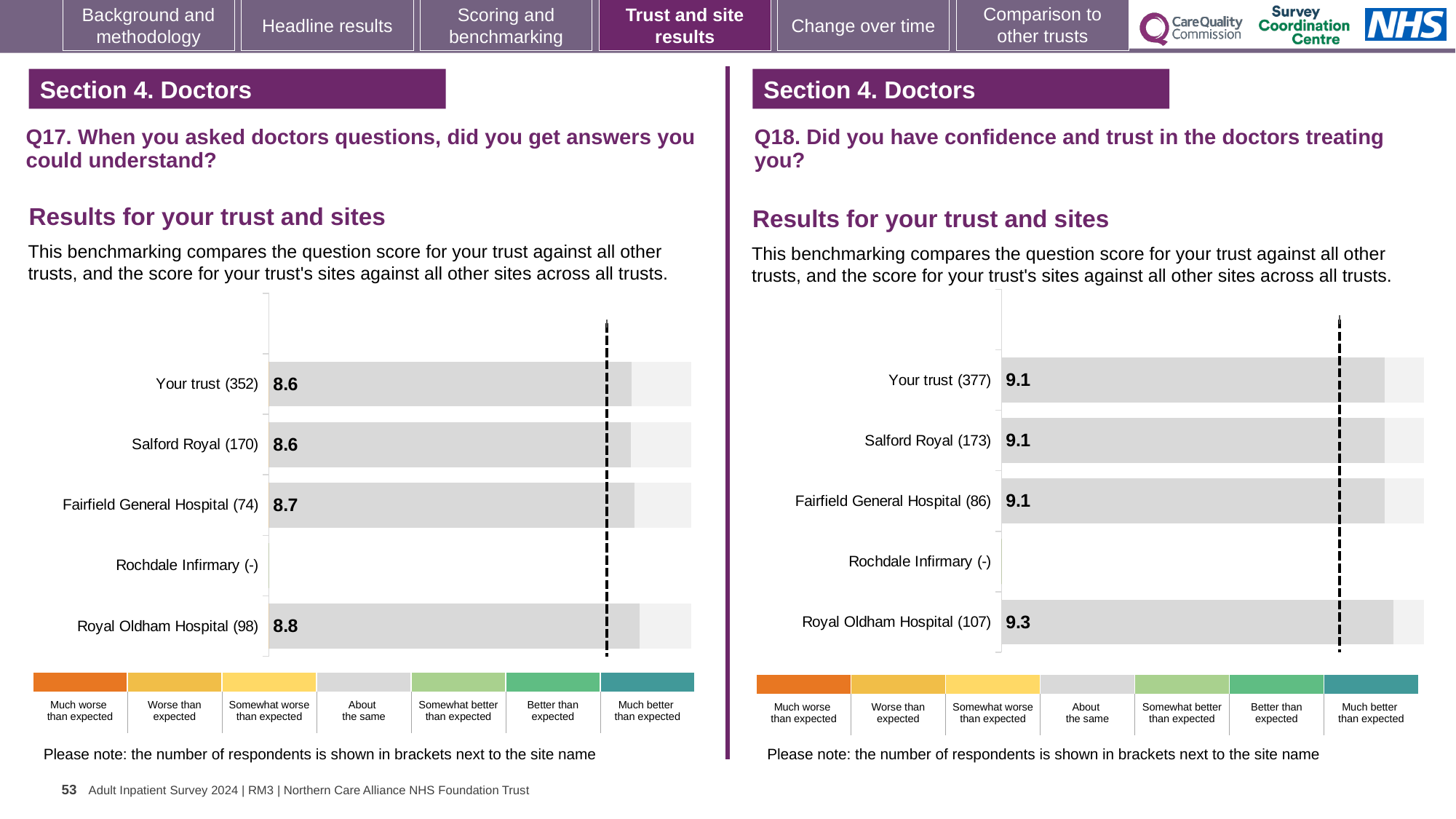
How many sites (including Your trust) are listed in the Q18 chart on the right? 5 In the Q17 chart on the left, which site has the highest score? Royal Oldham Hospital In the Q17 chart on the left, which has the higher score, Fairfield General Hospital or Salford Royal? Fairfield General Hospital In the Q17 chart on the left, what is the score for Royal Oldham Hospital? 8.8 In the Q18 chart on the right, what is the score for Your trust? 9.1 In the Q17 chart on the left, what is the score for Fairfield General Hospital? 8.7 In the Q18 chart on the right, which site has the highest score? Royal Oldham Hospital What type of chart is used for the Q17 results on the left? Bar chart In the Q17 chart on the left, what is the difference between the scores for Royal Oldham Hospital and Your trust? 0.2 In the Q18 chart on the right, what is the difference between the scores for Royal Oldham Hospital and Fairfield General Hospital? 0.2 In the Q18 chart on the right, what is the score for Royal Oldham Hospital? 9.3 In the Q17 chart on the left, how many respondents are shown in brackets for Salford Royal? 170